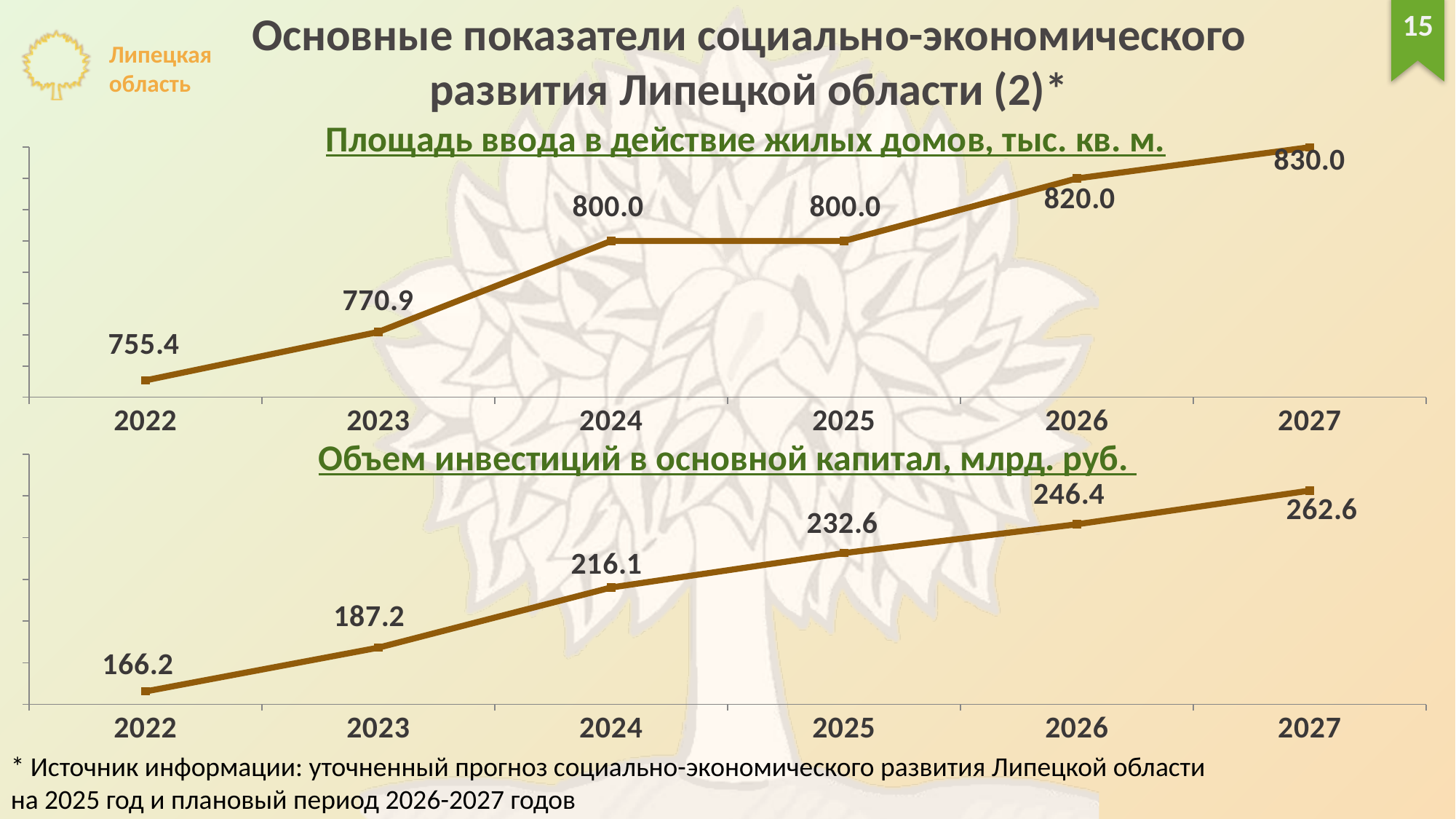
What unit is given in the title of the bottom chart? млрд. руб. In the bottom chart (Объем инвестиций в основной капитал), what is the value for 2025? 232.6 In the bottom chart (Объем инвестиций в основной капитал), do the values rise or fall from 2022 to 2027? rise In the top chart (Площадь ввода в действие жилых домов), how many data points are plotted? 6 In the bottom chart (Объем инвестиций в основной капитал), which year has the highest value? 2027 In the top chart (Площадь ввода в действие жилых домов), what kind of chart is shown? line chart In the bottom chart (Объем инвестиций в основной капитал), what is the difference between the 2023 and 2022 values? 21.0 In the top chart (Площадь ввода в действие жилых домов), which year has the lowest value? 2022 In the top chart (Площадь ввода в действие жилых домов), what is the difference between the 2026 and 2022 values? 64.6 In the bottom chart (Объем инвестиций в основной капитал), which is larger: the value for 2024 or the value for 2026? 2026 In the top chart (Площадь ввода в действие жилых домов), what is the value for 2027? 830.0 In the top chart (Площадь ввода в действие жилых домов), what is the value for 2023? 770.9